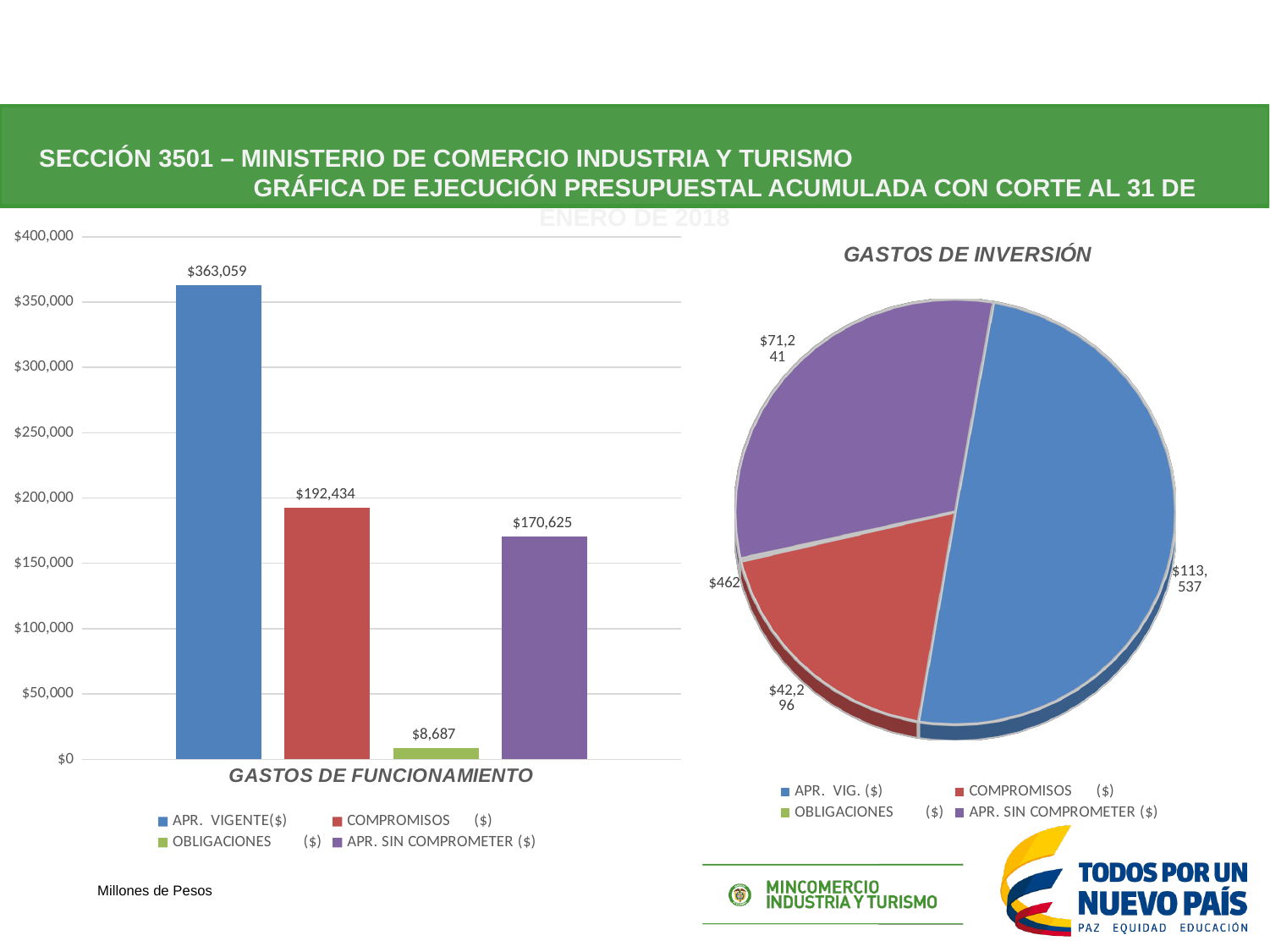
In the GASTOS DE INVERSIÓN pie chart, what is the value for COMPROMISOS ($)? $42,296 In the GASTOS DE FUNCIONAMIENTO bar chart, what is the value for OBLIGACIONES ($)? $8,687 What kind of chart is the GASTOS DE FUNCIONAMIENTO chart? bar chart In the GASTOS DE INVERSIÓN pie chart, what is the value for APR. SIN COMPROMETER ($)? $71,241 In the GASTOS DE FUNCIONAMIENTO bar chart, what is the difference between COMPROMISOS ($) and APR. SIN COMPROMETER ($)? $21,809 In the GASTOS DE INVERSIÓN pie chart, which slice is the largest? APR. VIG. ($) How many bars are plotted in the GASTOS DE FUNCIONAMIENTO bar chart? 4 In the GASTOS DE FUNCIONAMIENTO bar chart, which category has the lowest value? OBLIGACIONES ($) How many series does the legend of the GASTOS DE INVERSIÓN pie chart list? 4 In the GASTOS DE FUNCIONAMIENTO bar chart, is the value for COMPROMISOS ($) greater or less than $150,000? greater In the GASTOS DE FUNCIONAMIENTO bar chart, which category has the highest value? APR. VIGENTE($) In the GASTOS DE FUNCIONAMIENTO bar chart, what is the value for APR. VIGENTE($)? $363,059